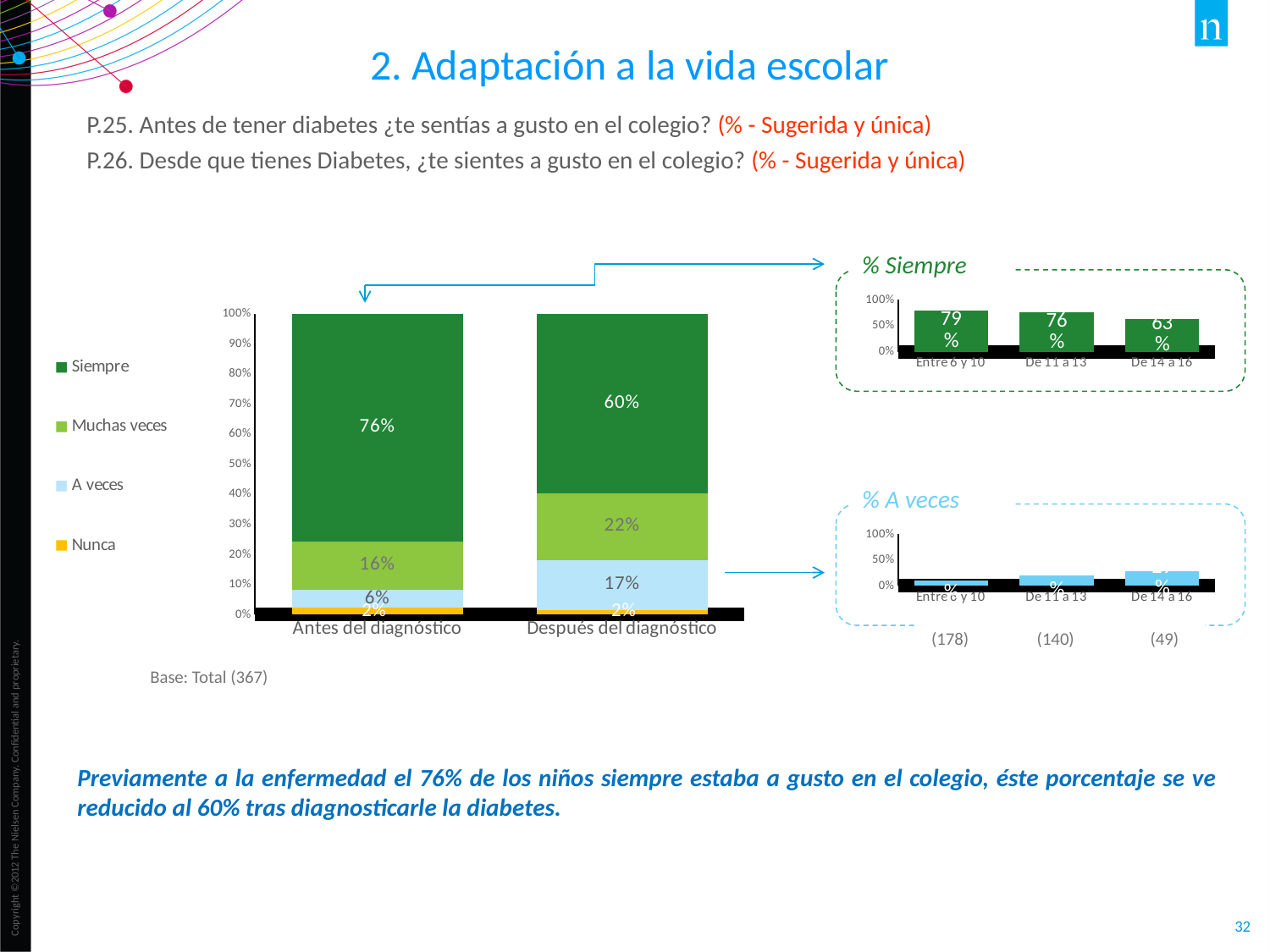
In the main stacked bar chart, by how many percentage points did the 'Siempre' share fall from 'Antes del diagnóstico' to 'Después del diagnóstico'? 16 percentage points In the main stacked bar chart, what is the value of 'A veces' for 'Después del diagnóstico'? 17% In the main stacked bar chart, what is the value of 'Muchas veces' for 'Antes del diagnóstico'? 16% In the '% Siempre' chart, which age group has the lowest value? De 14 a 16 In the main stacked bar chart, what percentage of children answered 'Siempre' for 'Después del diagnóstico'? 60% How many series does the legend of the main stacked bar chart list? 4 In the main stacked bar chart, what percentage of children answered 'Siempre' for 'Antes del diagnóstico'? 76% What kind of chart is the main chart on the left of the slide? Stacked bar chart In the '% Siempre' chart, do the values rise or fall from 'Entre 6 y 10' to 'De 14 a 16'? Fall In the '% Siempre' chart, what is the value for 'Entre 6 y 10'? 79% In the main stacked bar chart, which category has the larger 'Muchas veces' value, 'Antes del diagnóstico' or 'Después del diagnóstico'? Después del diagnóstico In the '% Siempre' chart, what is the difference between 'Entre 6 y 10' and 'De 14 a 16'? 16 percentage points